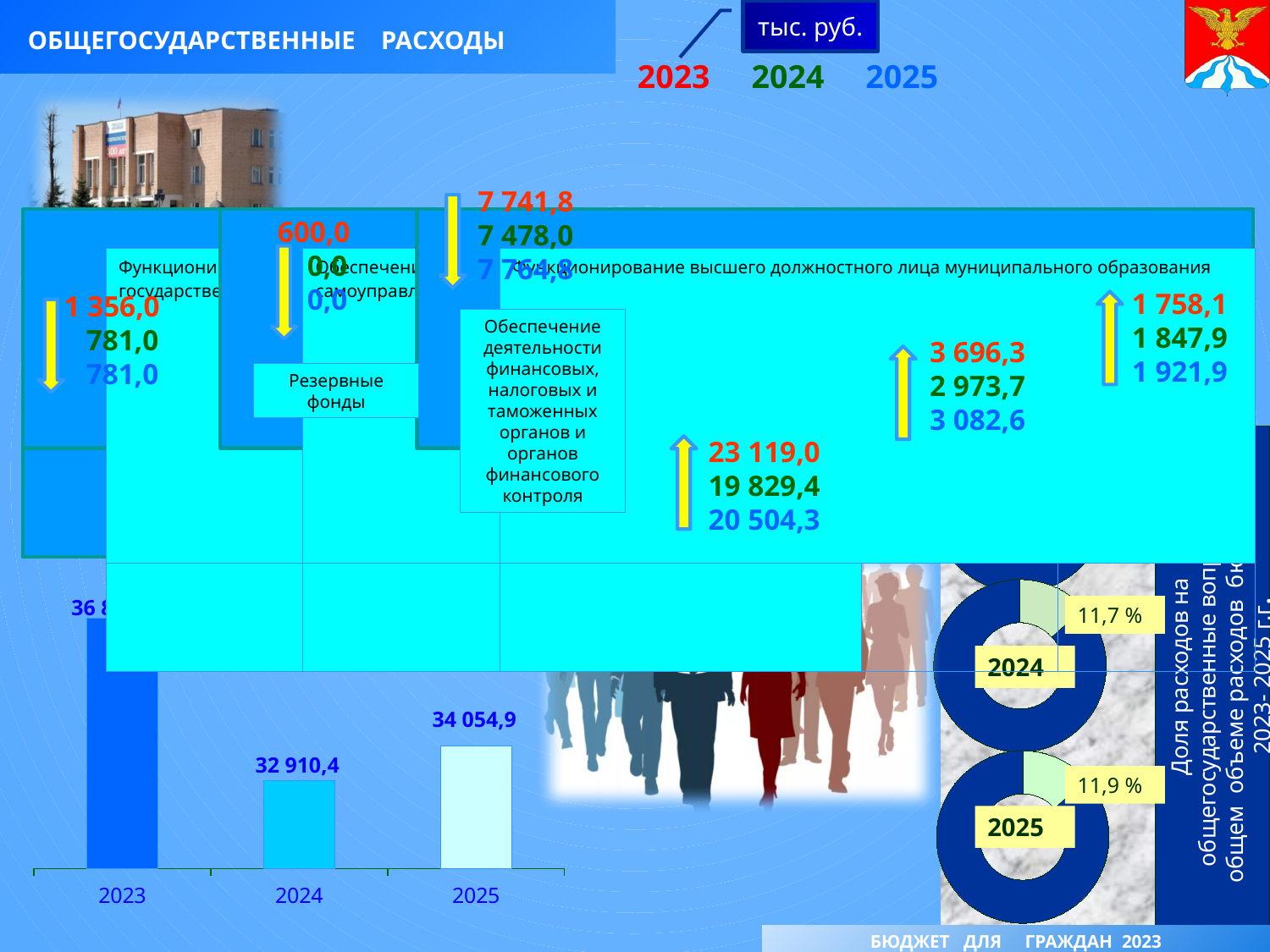
In the donut chart labelled 2024 at the bottom right, what share is shown? 11,7 % In the bar chart at the bottom left, which year has the tallest bar? 2023 In the bar chart at the bottom left, which year has the lowest value? 2024 In the bar chart at the bottom left, how many years are shown on the x axis? 3 What kind of chart is shown at the bottom left of the slide? bar chart In the bar chart at the bottom left, which is larger: the value for 2024 or the value for 2025? 2025 In the bar chart at the bottom left, does the value rise or fall from 2024 to 2025? rise In the donut chart labelled 2025 at the bottom right, what share is shown? 11,9 % In the bar chart at the bottom left, what is the difference between the values for 2025 and 2024? 1 144,5 In the bar chart at the bottom left, what is the value for 2024? 32 910,4 In the bar chart at the bottom left, what is the value for 2025? 34 054,9 Which of the two donut charts at the bottom right shows the larger share: 2024 or 2025? 2025